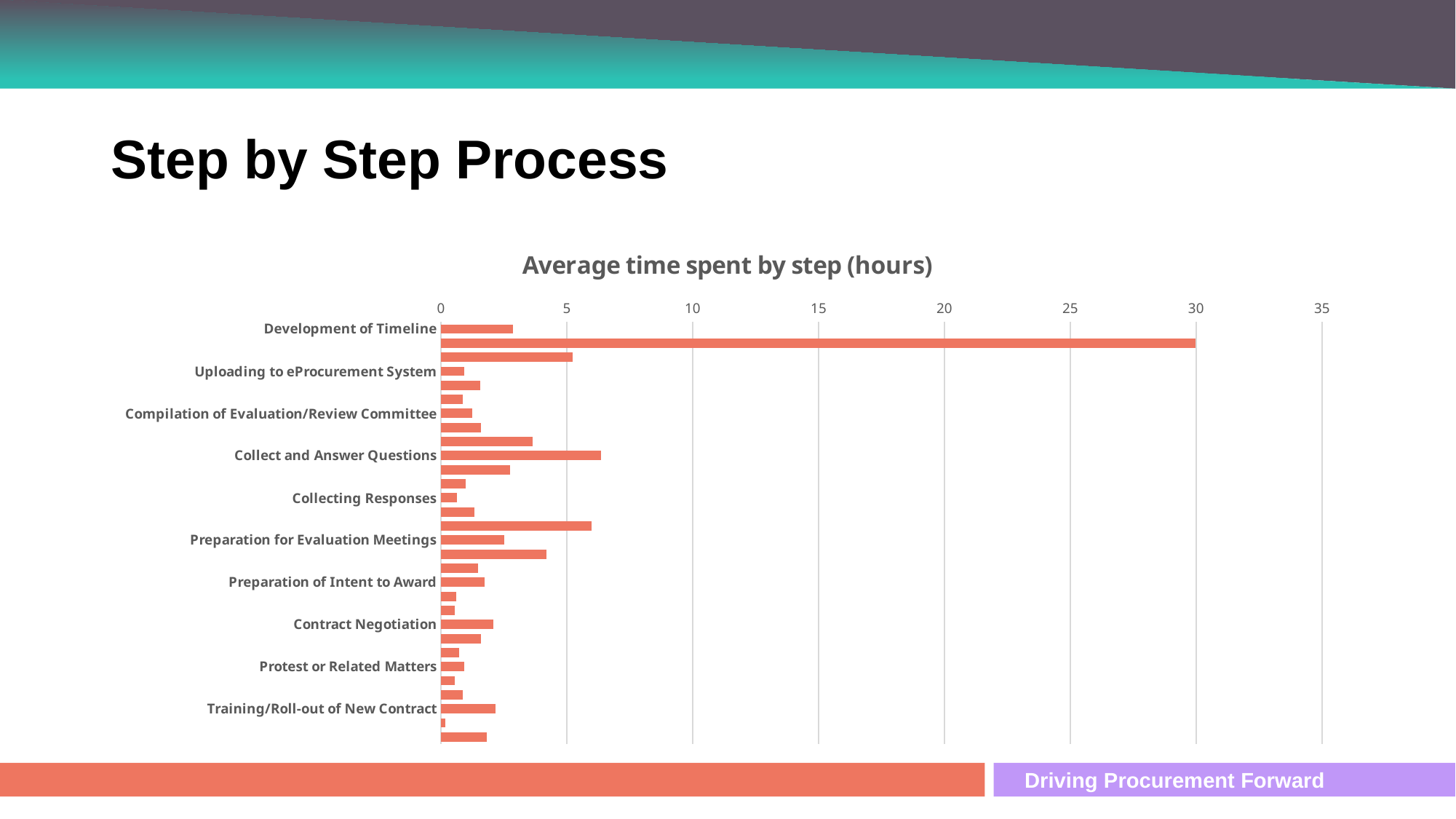
Is the longest bar on the chart greater or less than 25? greater Which is larger, the value for Collect and Answer Questions or the value for Collecting Responses? Collect and Answer Questions Which is larger, the value for Collect and Answer Questions or the value for Development of Timeline? Collect and Answer Questions What is the title of the chart? Average time spent by step (hours) Is the value for Collecting Responses greater or less than 5? less Is the value for Uploading to eProcurement System greater or less than 5? less How many category labels are shown on the vertical axis of the chart? 10 What is the highest tick value shown on the horizontal axis? 35 What kind of chart is shown on the slide? bar chart